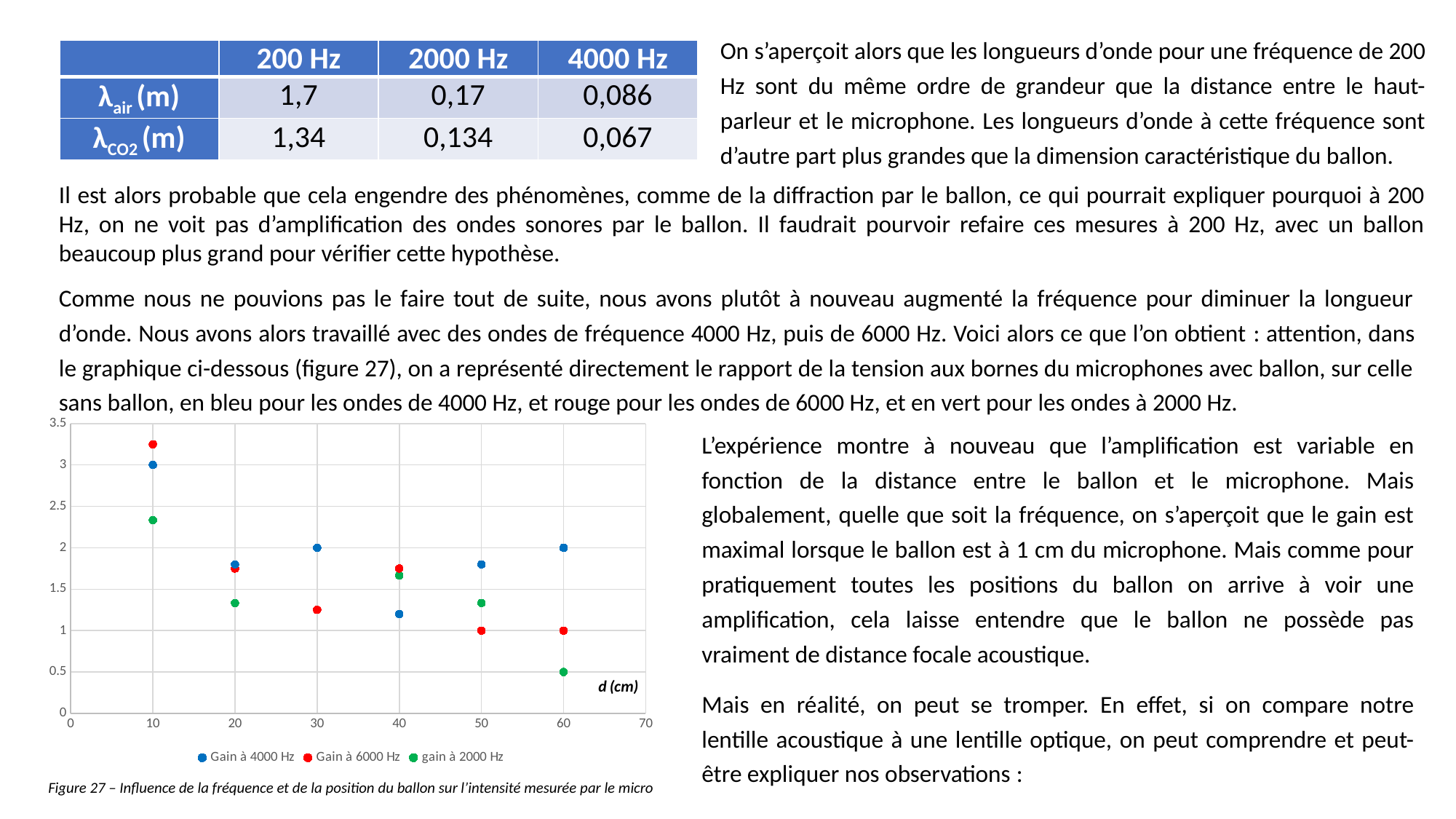
Which series has the lowest point on the chart? gain à 2000 Hz How many series does the legend of the chart list? 3 Is the value of Gain à 6000 Hz at d = 10 cm greater or less than 3? greater What kind of chart is shown in Figure 27? scatter chart What is the value of Gain à 4000 Hz at d = 10 cm? 3 What is the value of Gain à 6000 Hz at d = 60 cm? 1 What is the value of gain à 2000 Hz at d = 60 cm? 0.5 At d = 60 cm, which is larger: Gain à 4000 Hz or Gain à 6000 Hz? Gain à 4000 Hz Which series has the highest point on the chart? Gain à 6000 Hz Is the value of gain à 2000 Hz at d = 10 cm greater or less than 2? greater Is the value of Gain à 4000 Hz at d = 40 cm greater or less than 1.5? less